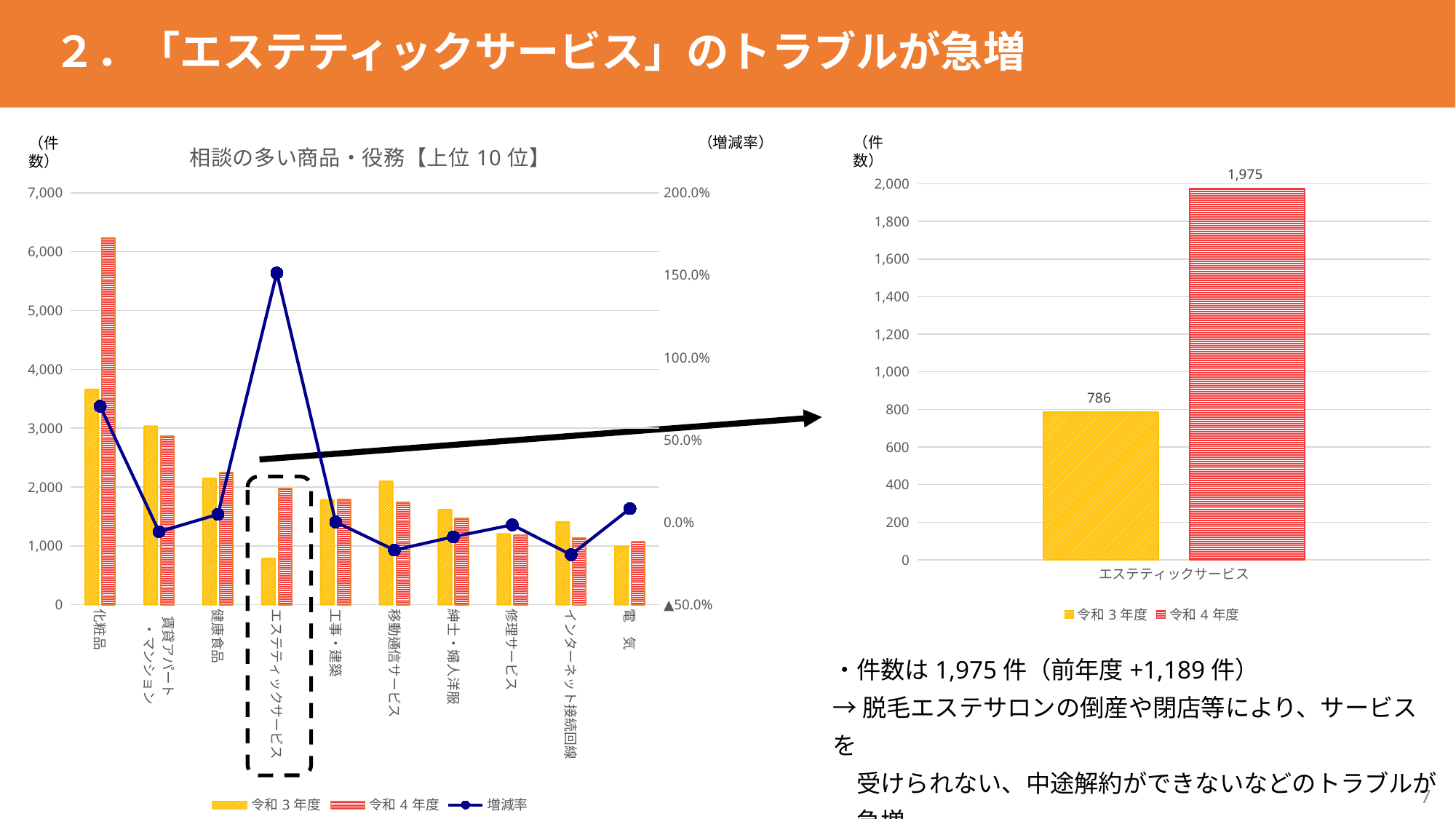
In the chart titled 相談の多い商品・役務【上位10位】, how many series does the legend list? 3 In the right chart, which is larger for エステティックサービス: the 令和3年度 value or the 令和4年度 value? 令和4年度 In the right chart, what is the value for 令和4年度 for エステティックサービス? 1,975 In the right chart, how many series does the legend list? 2 What kind of chart is the right chart? bar chart In the chart titled 相談の多い商品・役務【上位10位】, how many categories are shown on the x axis? 10 In the right chart, what is the value for 令和3年度 for エステティックサービス? 786 In the chart titled 相談の多い商品・役務【上位10位】, which category has the highest 令和4年度 bar? 化粧品 In the chart titled 相談の多い商品・役務【上位10位】, is the 令和4年度 value for 化粧品 greater or less than 6,000? greater In the chart titled 相談の多い商品・役務【上位10位】, which category has the highest 増減率 point? エステティックサービス In the right chart, what is the difference between the 令和4年度 and 令和3年度 values for エステティックサービス? 1,189 In the chart titled 相談の多い商品・役務【上位10位】, is the 令和3年度 value for エステティックサービス greater or less than 1,000? less